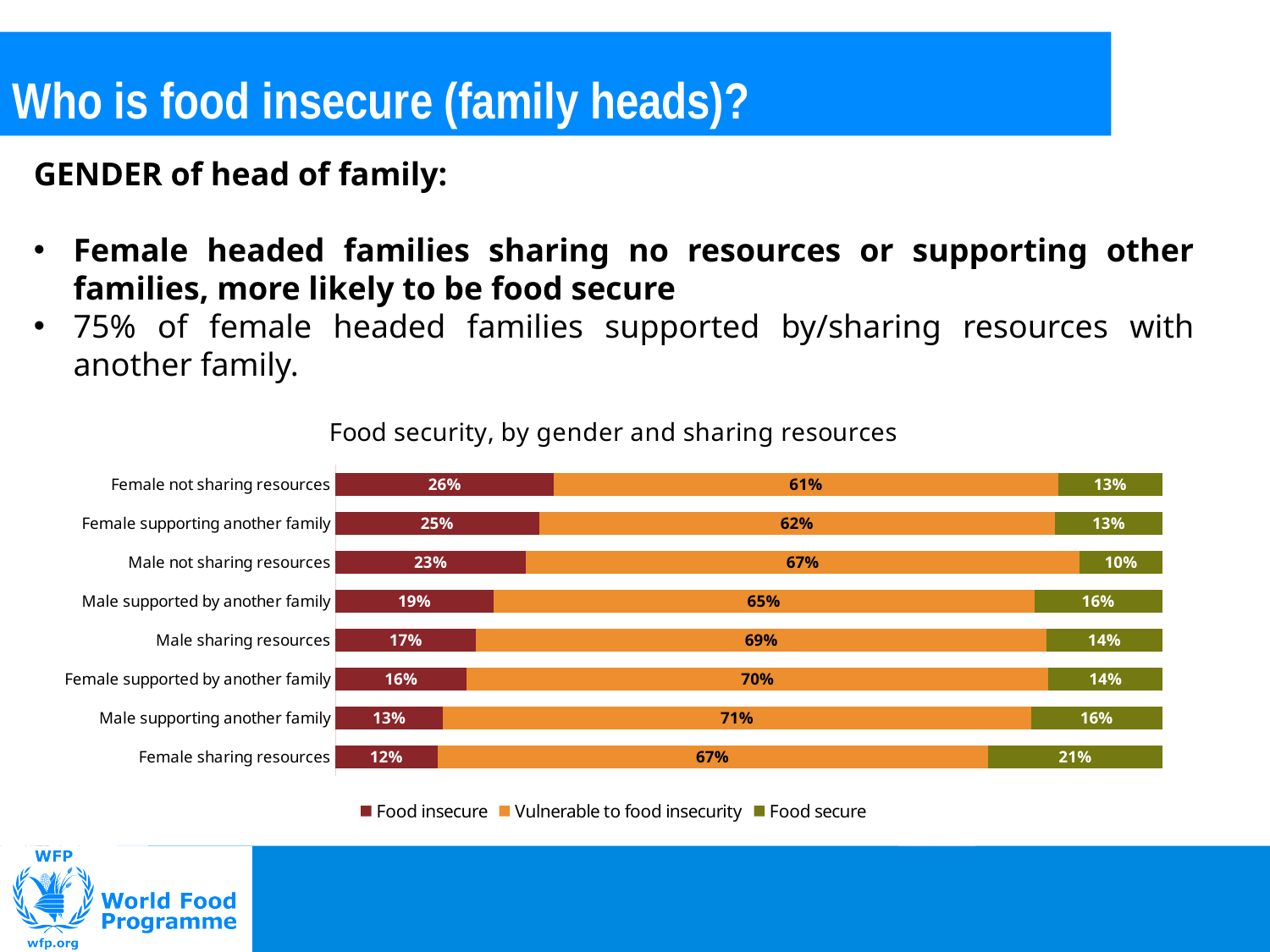
How many series does the legend list? 3 What is the difference between the Food insecure values for Female not sharing resources and Female sharing resources? 14% What is the title of the chart? Food security, by gender and sharing resources Which category has the lowest Food secure value? Male not sharing resources What is the Food insecure value for Female not sharing resources? 26% What is the Vulnerable to food insecurity value for Male supporting another family? 71% What is the Food secure value for Female sharing resources? 21% How many categories are shown on the chart? 8 Which category has the highest Food insecure value? Female not sharing resources Which series is shown in orange in the legend? Vulnerable to food insecurity Which is larger: the Food secure value for Male supported by another family or for Male sharing resources? Male supported by another family What kind of chart is shown on the slide? Stacked bar chart